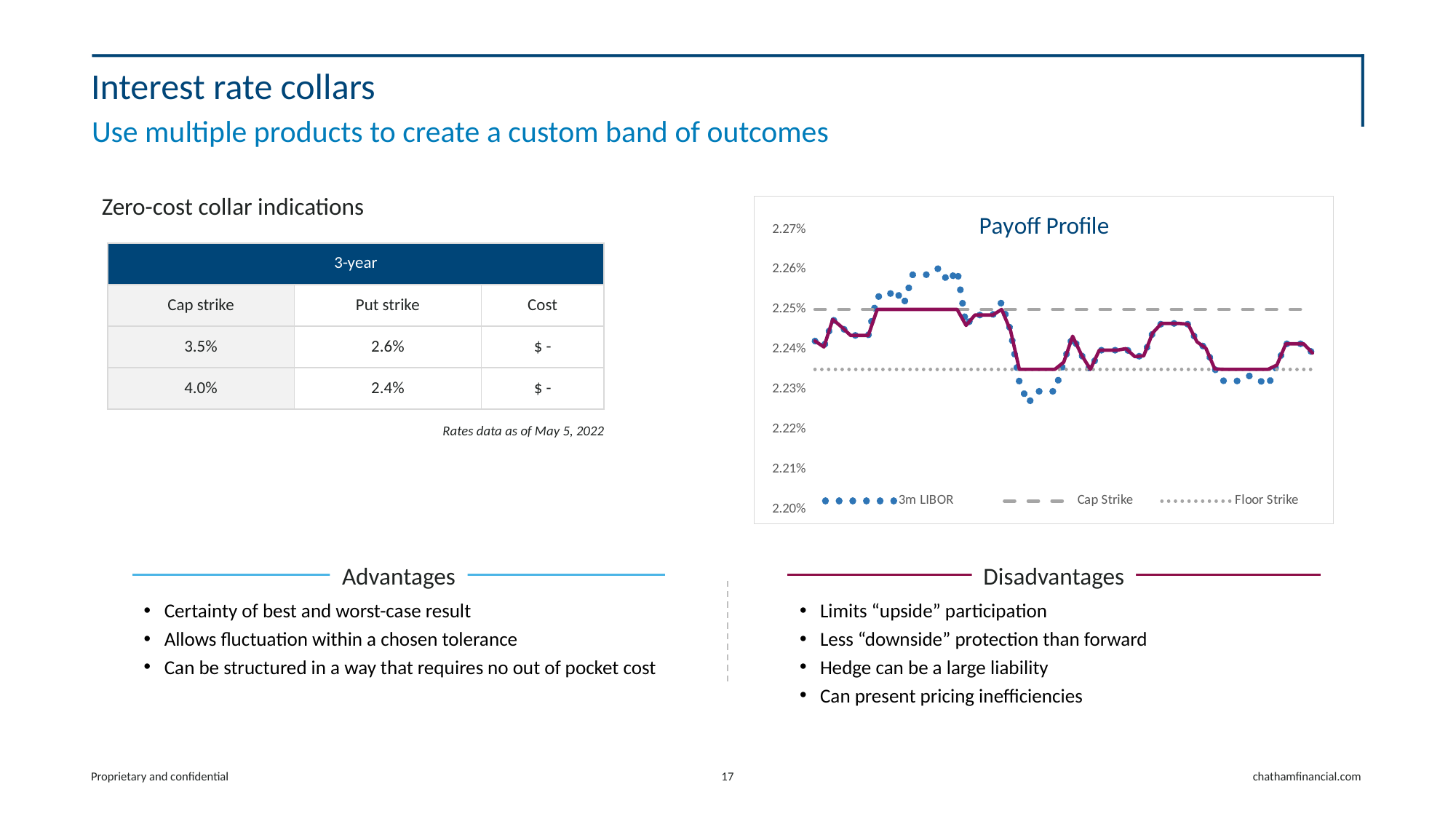
In the Payoff Profile chart, is the lowest 3m LIBOR point greater or less than 2.24%? less In the Payoff Profile chart, is the highest 3m LIBOR point greater or less than 2.27%? less In the Payoff Profile chart, which is higher, the Cap Strike line or the Floor Strike line? Cap Strike In the Payoff Profile chart, is the highest 3m LIBOR point greater or less than 2.25%? greater In the Payoff Profile chart, at what rate is the Cap Strike line drawn? 2.25% What is the lowest value shown on the y axis of the Payoff Profile chart? 2.20% What kind of chart is the Payoff Profile chart? line chart How many series does the legend of the Payoff Profile chart list? 3 What is the title of the chart on the slide? Payoff Profile